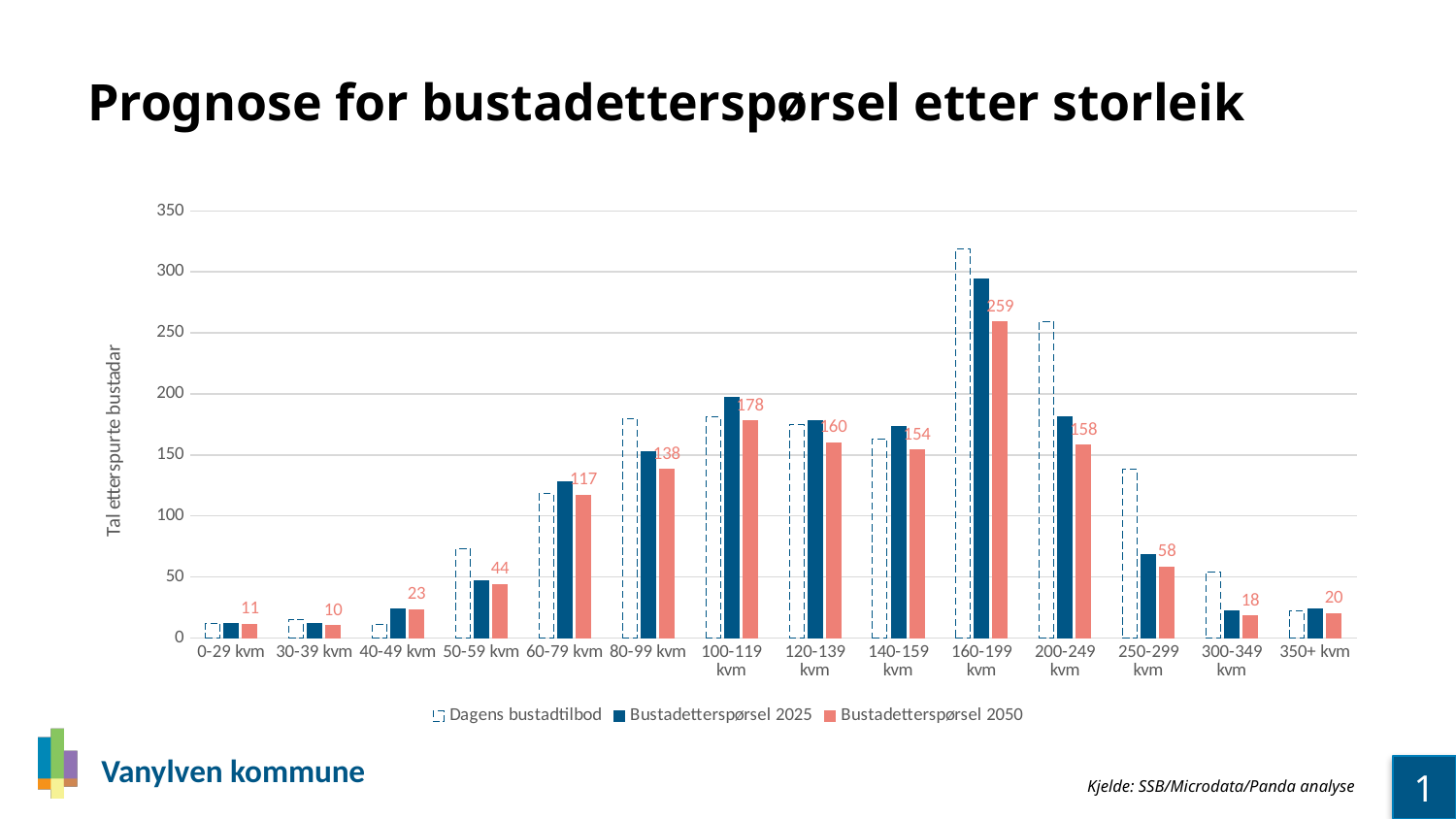
What is the Bustadetterspørsel 2050 value for 60-79 kvm? 117 Which size category has the lowest Bustadetterspørsel 2050 value? 30-39 kvm What is the Bustadetterspørsel 2050 value for 160-199 kvm? 259 Is the Dagens bustadtilbod value for 160-199 kvm greater or less than 300? greater What kind of chart is shown on the slide? bar chart How many size categories are shown on the x axis? 14 Which has the larger Bustadetterspørsel 2050 value, 80-99 kvm or 60-79 kvm? 80-99 kvm How many series does the legend list? 3 What is the difference between the Bustadetterspørsel 2050 values for 100-119 kvm and 120-139 kvm? 18 Is the Dagens bustadtilbod value for 200-249 kvm greater or less than 200? greater Which size category has the highest Bustadetterspørsel 2050 value? 160-199 kvm Is the Bustadetterspørsel 2025 value for 160-199 kvm greater or less than 250? greater